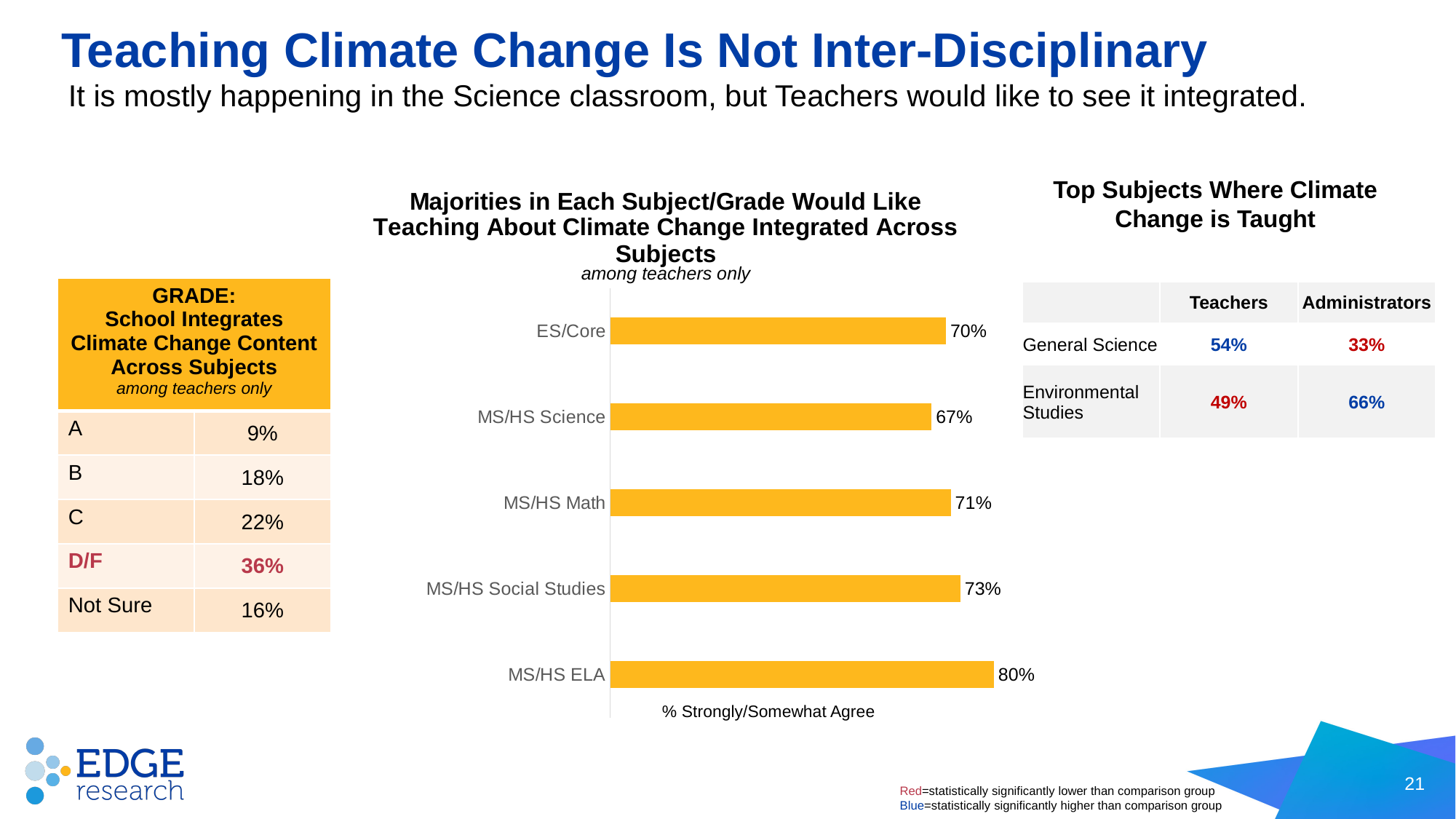
What is the axis label shown beneath the bars in the bar chart? % Strongly/Somewhat Agree In the bar chart, which subject/grade has the highest value? MS/HS ELA How many subject/grade categories are shown in the bar chart? 5 In the bar chart, which is larger: the value for MS/HS Social Studies or the value for MS/HS Math? MS/HS Social Studies In the bar chart, which subject/grade has the lowest value? MS/HS Science In the bar chart, what is the difference between the values for MS/HS Math and ES/Core? 1% In the bar chart, what is the value for MS/HS Social Studies? 73% In the bar chart, what is the value for MS/HS ELA? 80% According to the subtitle under the bar chart's title, which group are the results among? Teachers only In the bar chart, what is the difference between the values for MS/HS ELA and MS/HS Science? 13% What kind of chart is used to show the percentage who would like climate change teaching integrated across subjects? Bar chart In the bar chart, what is the value for ES/Core? 70%